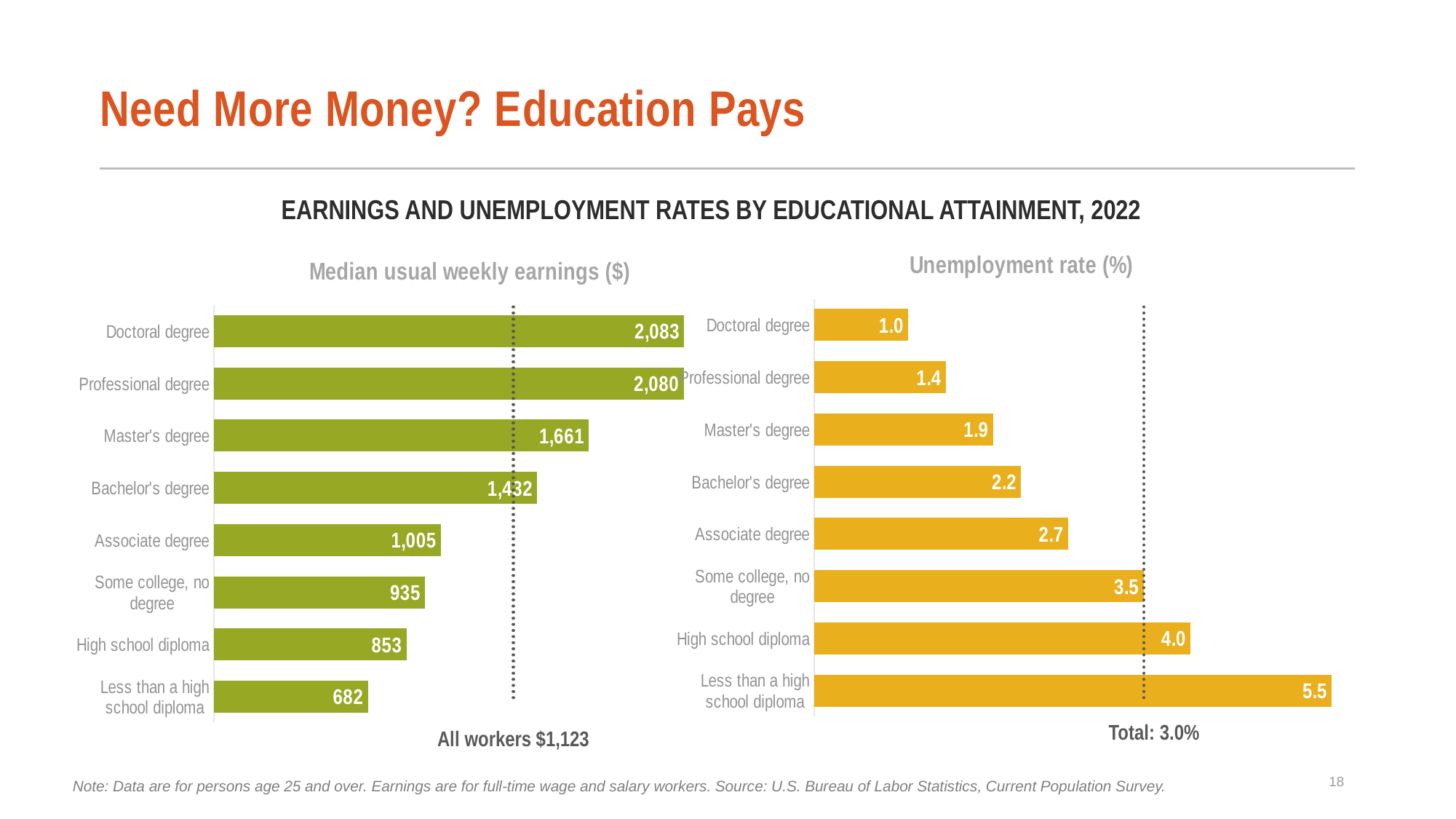
In the Unemployment rate (%) chart, which category has the lowest value? Doctoral degree What kind of chart is the Median usual weekly earnings ($) chart? Bar chart What value does the dotted reference line in the Median usual weekly earnings ($) chart represent? All workers $1,123 In the Median usual weekly earnings ($) chart, what is the difference between Bachelor's degree and High school diploma? 579 In the Unemployment rate (%) chart, which category has the highest value? Less than a high school diploma What value does the dotted reference line in the Unemployment rate (%) chart represent? Total: 3.0% In the Median usual weekly earnings ($) chart, what is the value for Master's degree? 1,661 In the Unemployment rate (%) chart, what is the value for Associate degree? 2.7 In the Median usual weekly earnings ($) chart, which is larger: Associate degree or Some college, no degree? Associate degree In the Unemployment rate (%) chart, what is the difference between High school diploma and Bachelor's degree? 1.8 In the Median usual weekly earnings ($) chart, which category has the highest value? Doctoral degree How many categories are shown in the Unemployment rate (%) chart? 8